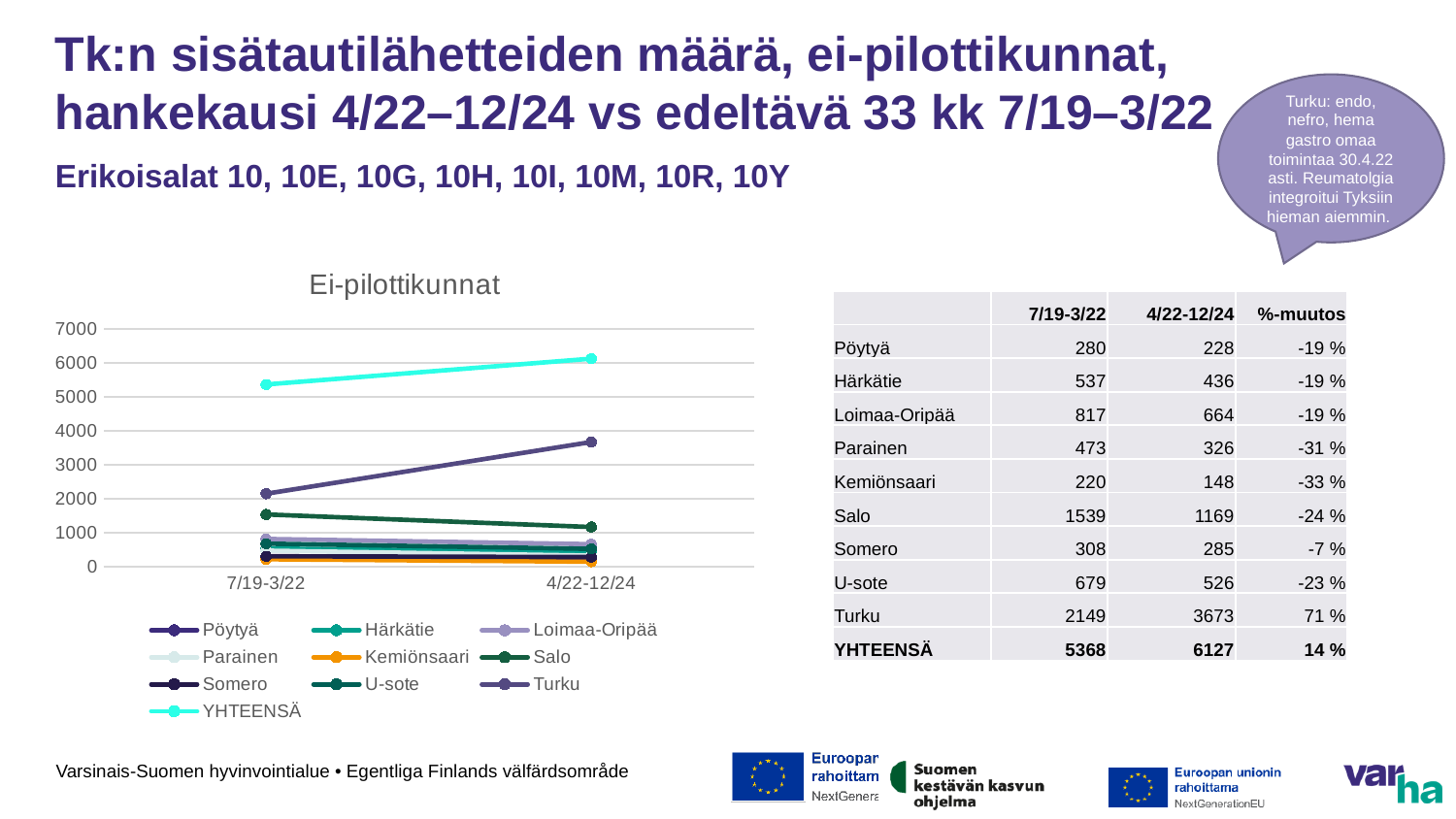
Is the value for YHTEENSÄ at 7/19-3/22 greater or less than 5000? greater What kind of chart is shown on the slide? line chart How many series does the legend of the Ei-pilottikunnat chart list? 10 Which series has the highest value at 4/22-12/24 in the Ei-pilottikunnat chart? YHTEENSÄ According to the table, what is the value for Turku in the period 4/22-12/24? 3673 Does the YHTEENSÄ line rise or fall from 7/19-3/22 to 4/22-12/24? rises How many points are there on the x axis of the Ei-pilottikunnat chart? 2 According to the table, what is the difference between the YHTEENSÄ values for 4/22-12/24 and 7/19-3/22? 759 Does the Salo line rise or fall from 7/19-3/22 to 4/22-12/24? falls What is the title of the line chart? Ei-pilottikunnat Is the value for Turku at 4/22-12/24 greater or less than 3000? greater At 4/22-12/24, which is larger, the value for Turku or the value for Salo? Turku